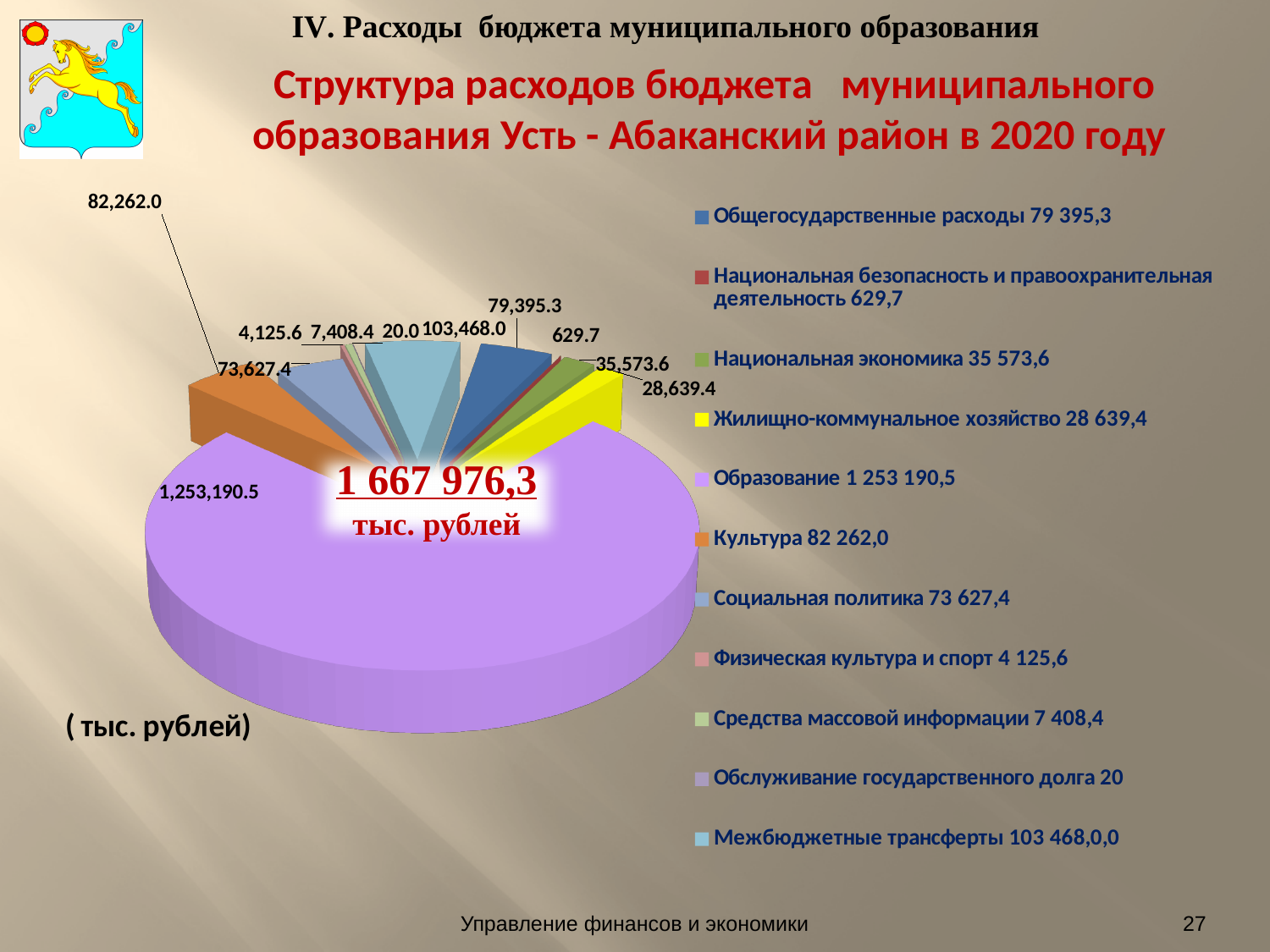
What is the difference between the values for Межбюджетные трансферты (103,468.0) and Общегосударственные расходы (79,395.3)? 24,072.7 What value is labelled on the pie chart for Культура? 82,262.0 What total value is printed in the centre of the pie chart? 1 667 976,3 тыс. рублей What is the difference between the values for Культура (82,262.0) and Социальная политика (73,627.4)? 8,634.6 Which category has the largest slice of the pie chart? Образование What value does the legend give for Национальная безопасность и правоохранительная деятельность? 629,7 What value is labelled on the pie chart for Образование? 1,253,190.5 Which category has the smallest slice of the pie chart? Обслуживание государственного долга Which is larger: Общегосударственные расходы or Национальная экономика? Общегосударственные расходы How many slices (categories) does the pie chart have? 11 What type of chart is shown on the slide? pie chart What value is labelled on the pie chart for Межбюджетные трансферты? 103,468.0